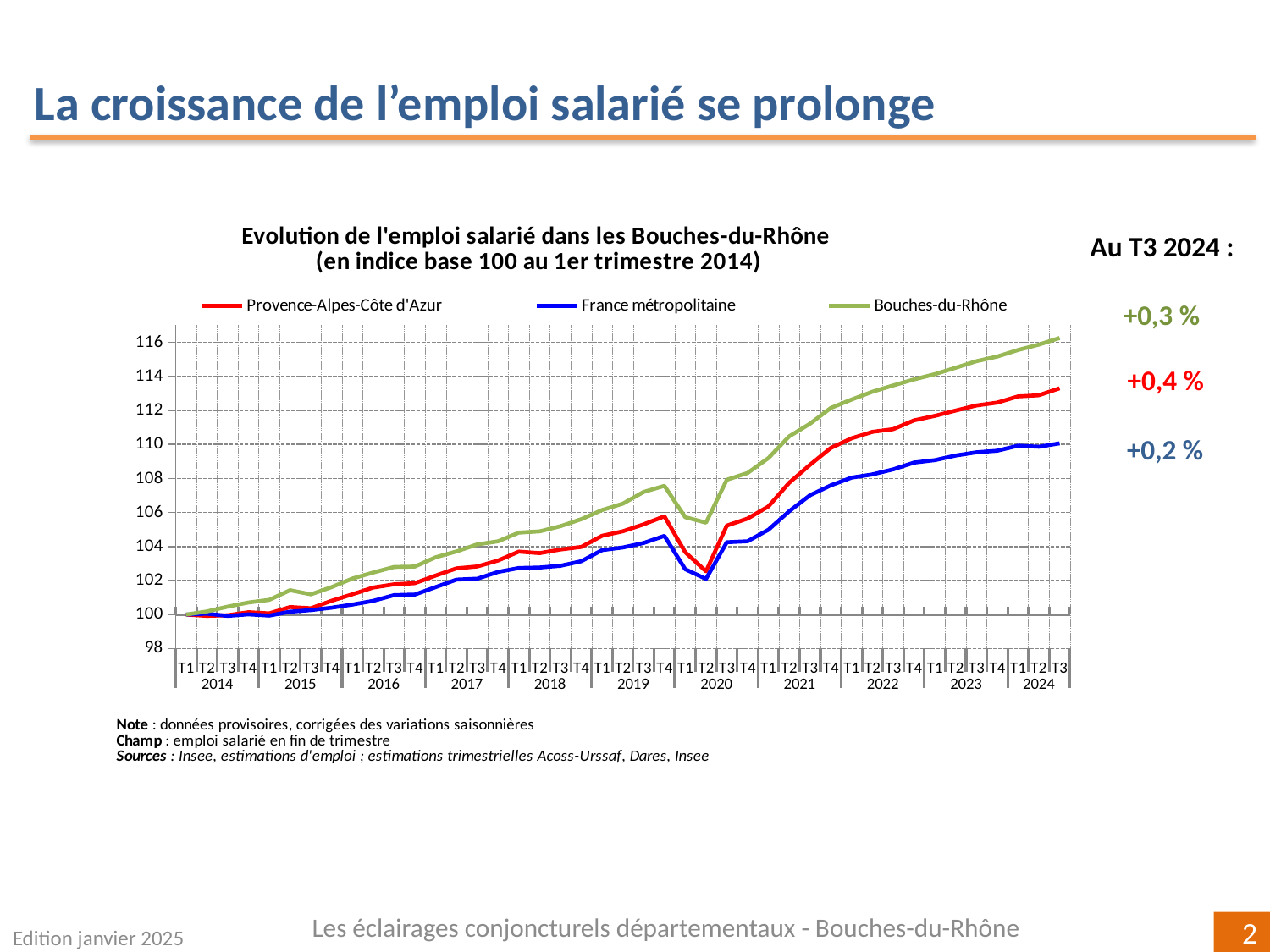
What is the index value of all three series at T1 2014? 100 Is the value for France métropolitaine at T3 2024 greater or less than 112? less Is the value for Bouches-du-Rhône at T3 2024 greater or less than 114? greater Which series has the highest value at T3 2024? Bouches-du-Rhône Overall, do the series rise or fall from 2014 to 2024? rise What type of chart is shown on the slide? line chart Which series are listed in the legend? Provence-Alpes-Côte d'Azur, France métropolitaine, Bouches-du-Rhône At T2 2020, which is higher: Bouches-du-Rhône or France métropolitaine? Bouches-du-Rhône What is the title of the chart? Evolution de l'emploi salarié dans les Bouches-du-Rhône (en indice base 100 au 1er trimestre 2014) How many series does the legend list? 3 What quarterly change is shown for Provence-Alpes-Côte d'Azur at T3 2024? +0,4 % Which series has the lowest value at T3 2024? France métropolitaine